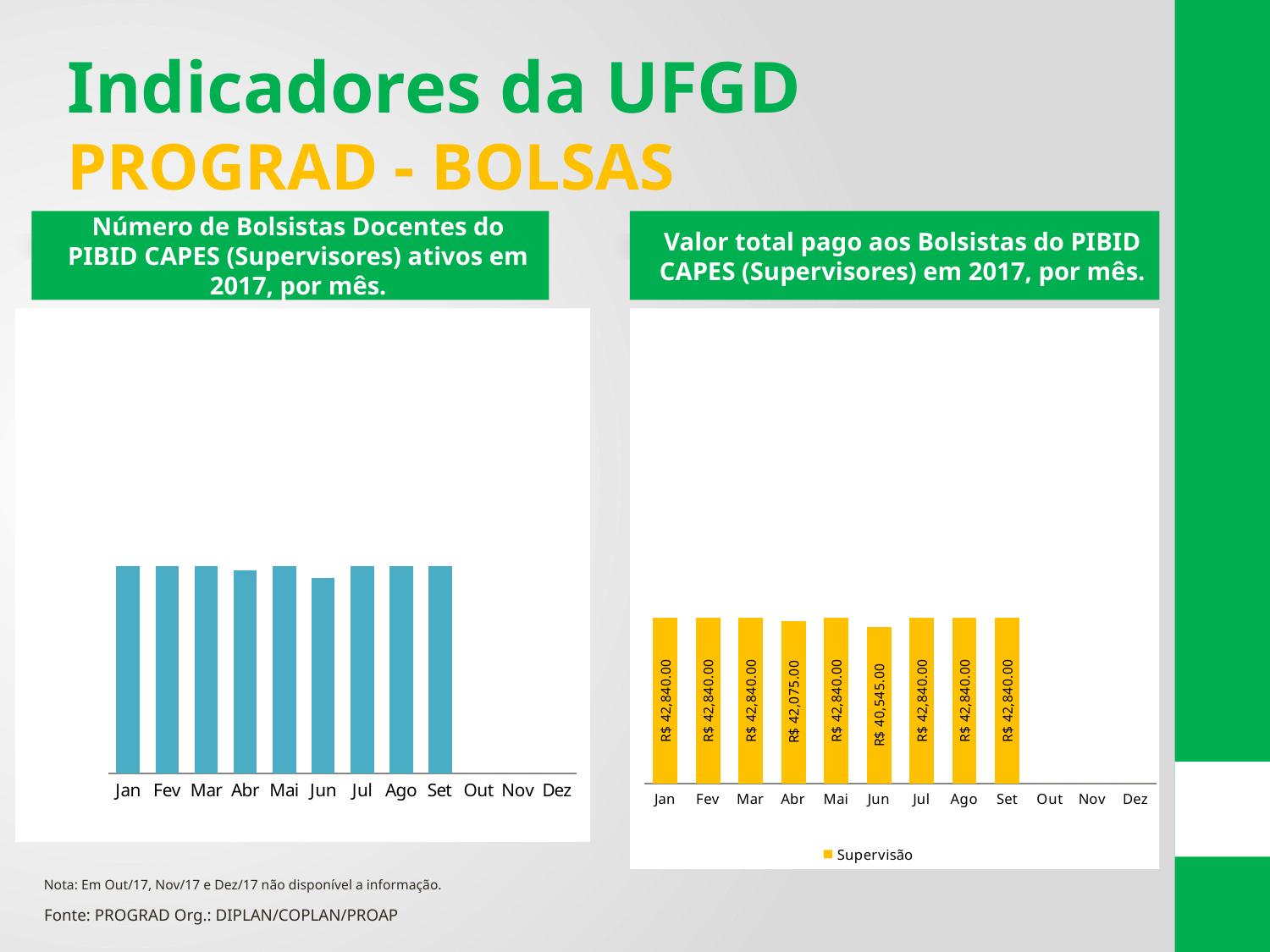
In the right chart (Valor total pago aos Bolsistas do PIBID CAPES), what is the value for Abr? R$ 42,075.00 In the right chart (Valor total pago aos Bolsistas do PIBID CAPES), which is larger, the value for Mar or the value for Abr? Mar In the right chart (Valor total pago aos Bolsistas do PIBID CAPES), what is the value for Jan? R$ 42,840.00 In the left chart (Número de Bolsistas Docentes do PIBID CAPES), which month has the lowest bar? Jun In the right chart (Valor total pago aos Bolsistas do PIBID CAPES), how many months have a bar plotted? 9 In the right chart (Valor total pago aos Bolsistas do PIBID CAPES), what is the difference between the values for Jan and Jun? R$ 2,295.00 What kind of chart is the left chart (Número de Bolsistas Docentes do PIBID CAPES)? Bar chart In the right chart (Valor total pago aos Bolsistas do PIBID CAPES), which month has the lowest value? Jun In the right chart (Valor total pago aos Bolsistas do PIBID CAPES), what is the difference between the values for Abr and Jun? R$ 1,530.00 In the right chart (Valor total pago aos Bolsistas do PIBID CAPES), how many series does the legend list? 1 In the right chart (Valor total pago aos Bolsistas do PIBID CAPES), what is the legend entry? Supervisão In the right chart (Valor total pago aos Bolsistas do PIBID CAPES), what is the value for Jun? R$ 40,545.00